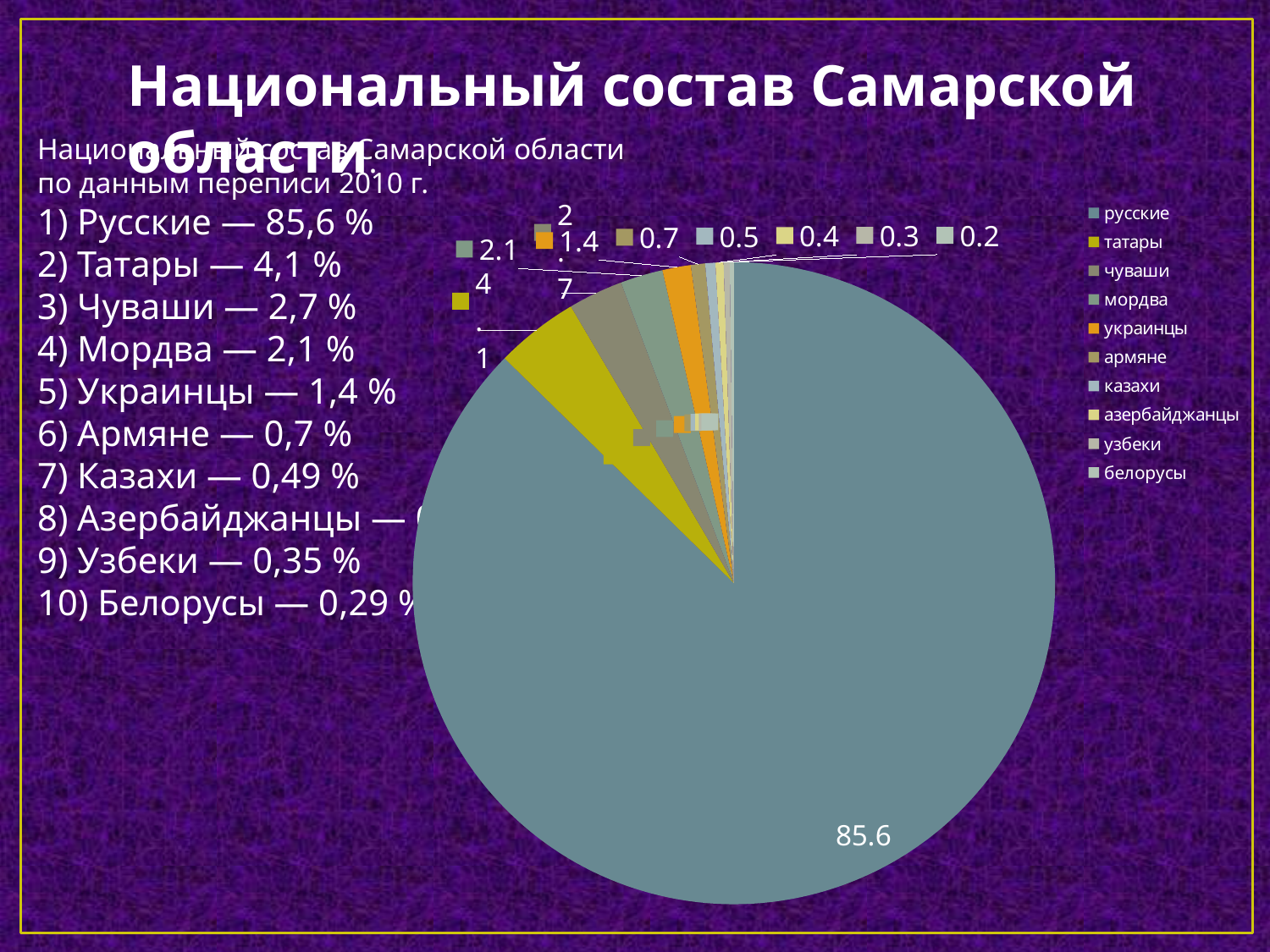
Which legend entry is listed first in the pie chart's legend? русские What kind of chart is shown on the slide? pie chart How many entries does the legend of the pie chart list? 10 What value is labelled for армяне in the pie chart? 0.7 What value is labelled on the largest slice of the pie chart (русские)? 85.6 Which category has the largest slice in the pie chart? русские What value is labelled for мордва in the pie chart? 2.1 What value is labelled for казахи in the pie chart? 0.5 Which slice is larger in the pie chart, мордва or украинцы? мордва What is the difference between the labelled values for мордва (2.1) and украинцы (1.4) in the pie chart? 0.7 Which category has the smallest slice in the pie chart? белорусы What value is labelled for украинцы in the pie chart? 1.4